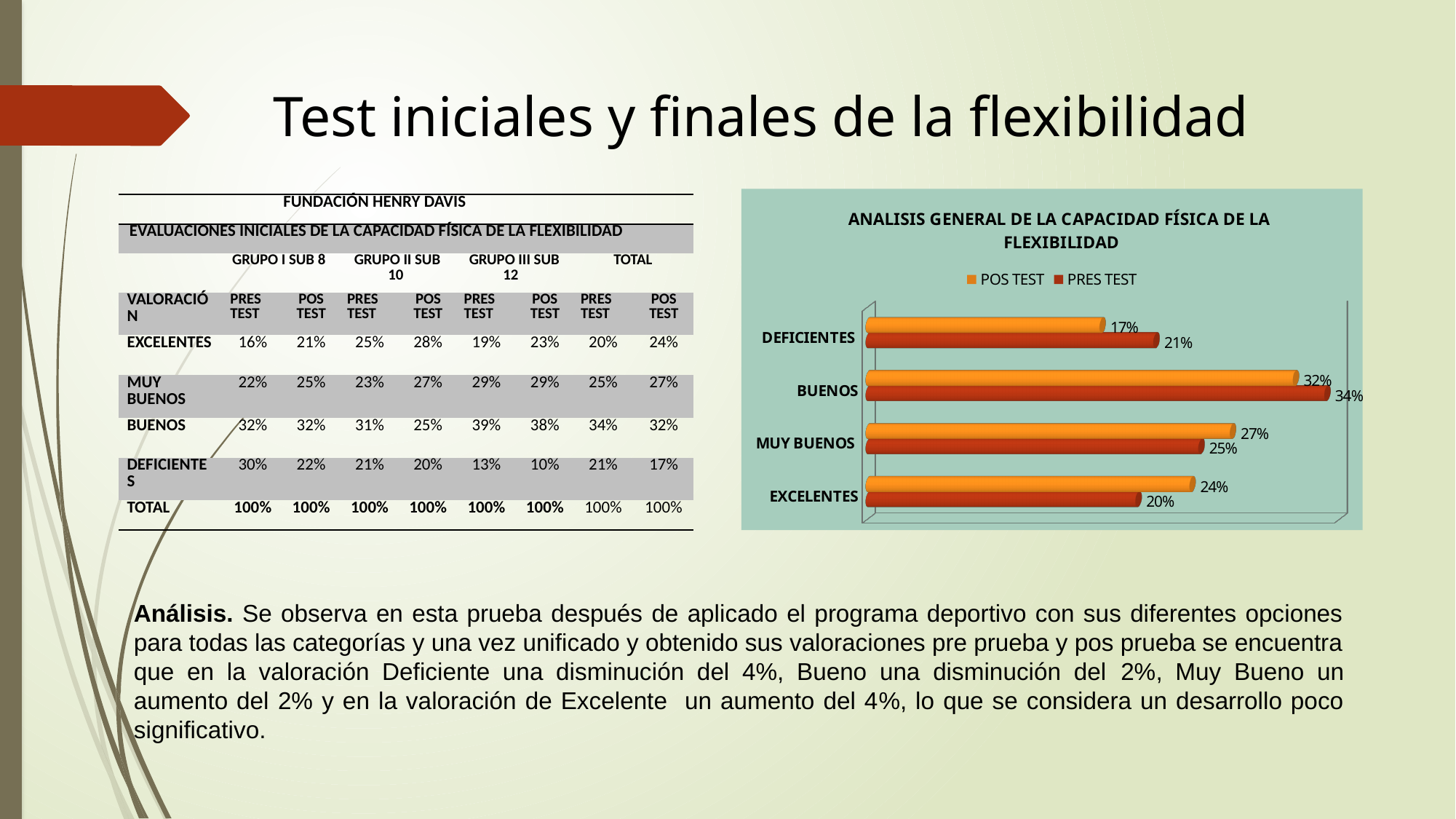
What is the PRES TEST value for DEFICIENTES? 21% What is the PRES TEST value for MUY BUENOS? 25% What is the title of the chart? ANALISIS GENERAL DE LA CAPACIDAD FÍSICA DE LA FLEXIBILIDAD Which is larger for EXCELENTES, the POS TEST value or the PRES TEST value? POS TEST What is the difference between the PRES TEST and POS TEST values for DEFICIENTES? 4% How many series does the legend list? 2 What kind of chart is shown on the slide? Bar chart How many categories are shown on the chart? 4 What is the POS TEST value for BUENOS? 32% What is the POS TEST value for EXCELENTES? 24% Which category has the highest PRES TEST value? BUENOS Which category has the lowest POS TEST value? DEFICIENTES